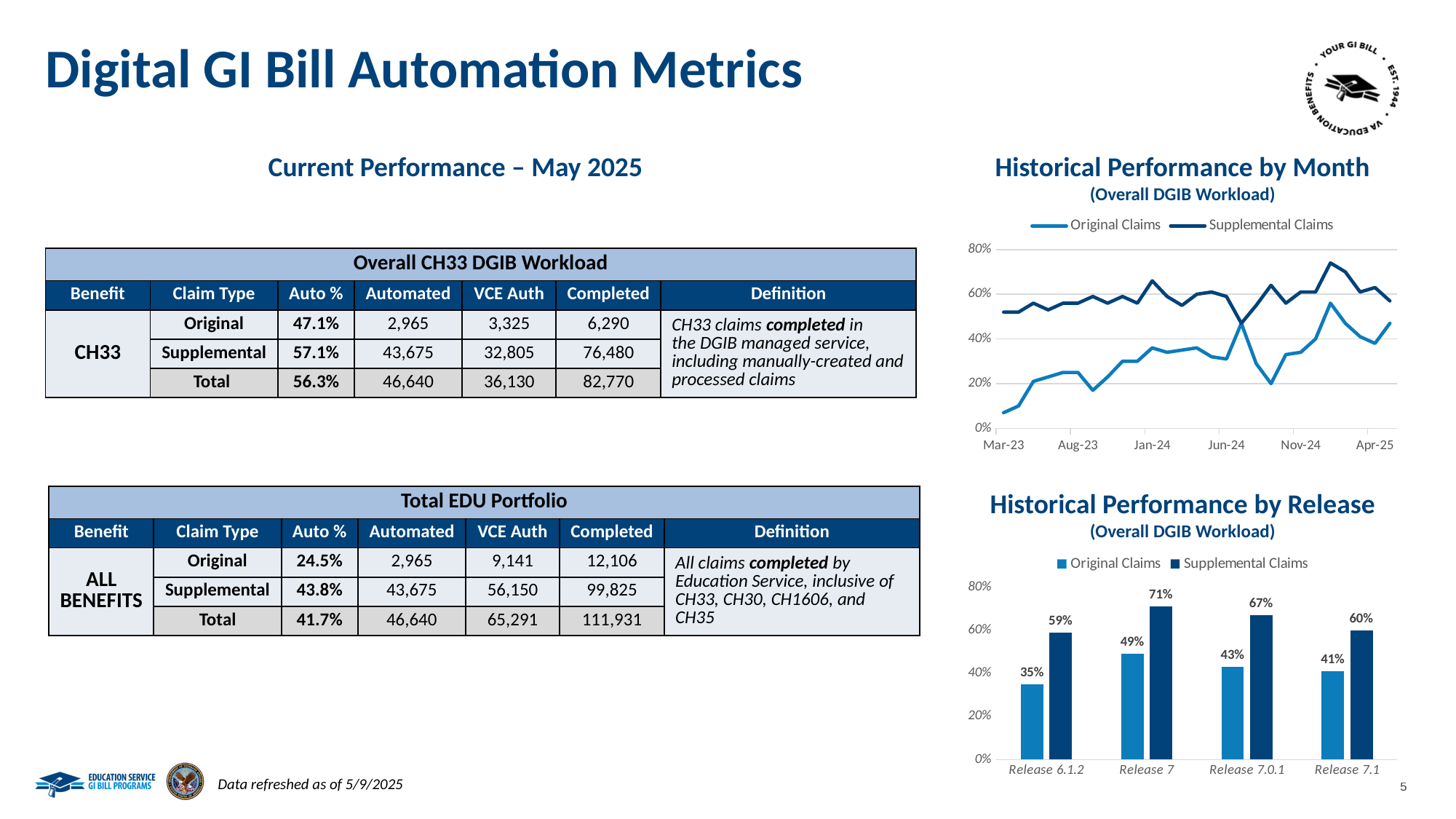
In the 'Historical Performance by Release' chart, which release has the highest Supplemental Claims value? Release 7 How many releases are shown on the x axis of the 'Historical Performance by Release' chart? 4 In the 'Historical Performance by Release' chart, what is the value for Original Claims for Release 7? 49% In the 'Historical Performance by Release' chart, what is the difference between Supplemental Claims and Original Claims for Release 6.1.2? 24% What type of chart is the 'Historical Performance by Month' chart? line chart How many series does the legend of the 'Historical Performance by Month' chart list? 2 What type of chart is the 'Historical Performance by Release' chart? bar chart In the 'Historical Performance by Release' chart, what is the value for Supplemental Claims for Release 7.0.1? 67% In the 'Historical Performance by Month' chart, is the Original Claims value at Mar-23 greater or less than 20%? less In the 'Historical Performance by Release' chart, which release has the lowest Original Claims value? Release 6.1.2 In the 'Historical Performance by Release' chart, which is larger for Release 7.1: Original Claims or Supplemental Claims? Supplemental Claims In the 'Historical Performance by Month' chart, does the Original Claims line generally rise or fall from Mar-23 to Apr-25? rise